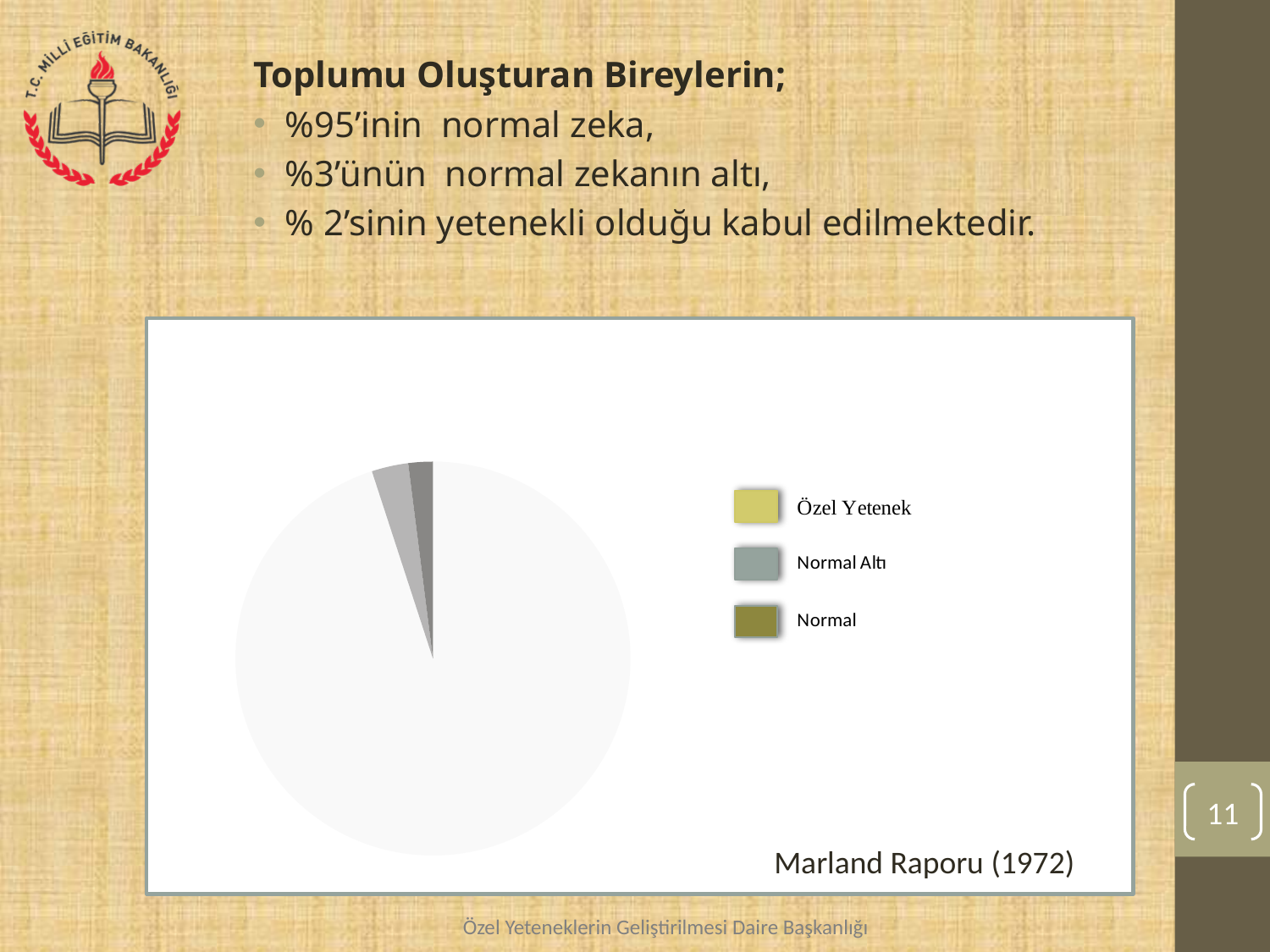
What kind of chart is shown on the slide? pie chart What share of the pie does the Normal category represent? %95 What share of the pie does the Normal Altı category represent? %3 How many slices does the pie chart have? 3 Which is larger in the pie chart, Normal or Normal Altı? Normal How many entries does the pie chart's legend list? 3 Which category has the largest slice in the pie chart? Normal Which category has the smallest slice in the pie chart? Özel Yetenek What source is cited below the pie chart? Marland Raporu (1972) What share of the pie does the Özel Yetenek category represent? %2 What is the difference between the Normal Altı share and the Özel Yetenek share? %1 What are the three entries listed in the pie chart's legend? Özel Yetenek, Normal Altı, Normal